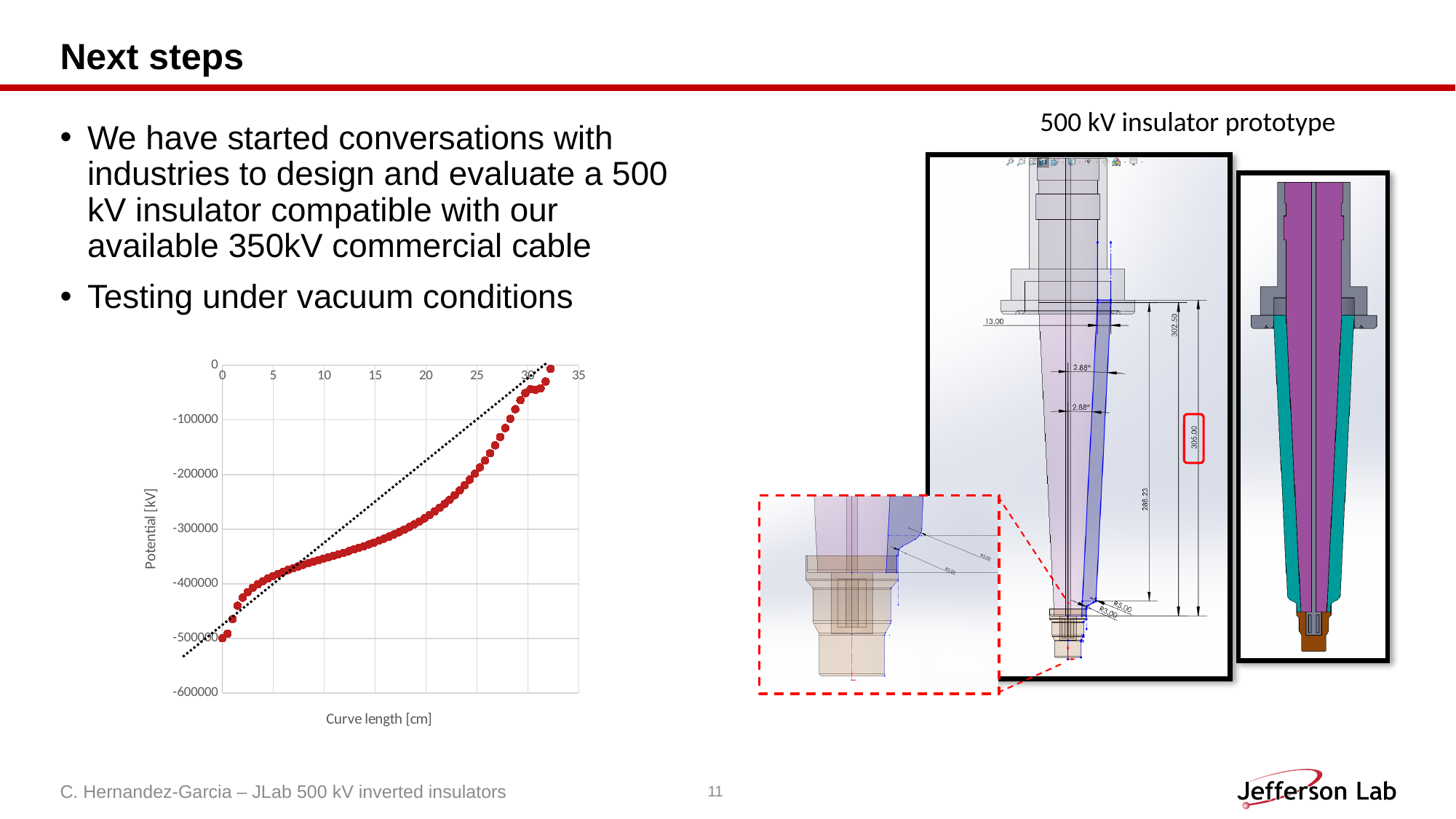
What kind of chart is shown on the slide? scatter chart Is the potential value at a curve length of 30 cm greater or less than -100000? greater Which has the higher potential value: the point at a curve length of 5 cm or the point at a curve length of 25 cm? 25 cm Is the potential value at a curve length of 10 cm greater or less than -300000? less Is the potential value at a curve length of 10 cm greater or less than -400000? greater Do the plotted potential values rise or fall as curve length increases along the x axis? rise What is the label of the y axis of the chart? Potential [kV] What is the label of the x axis of the chart? Curve length [cm] What is the lowest tick value shown on the y axis of the chart? -600000